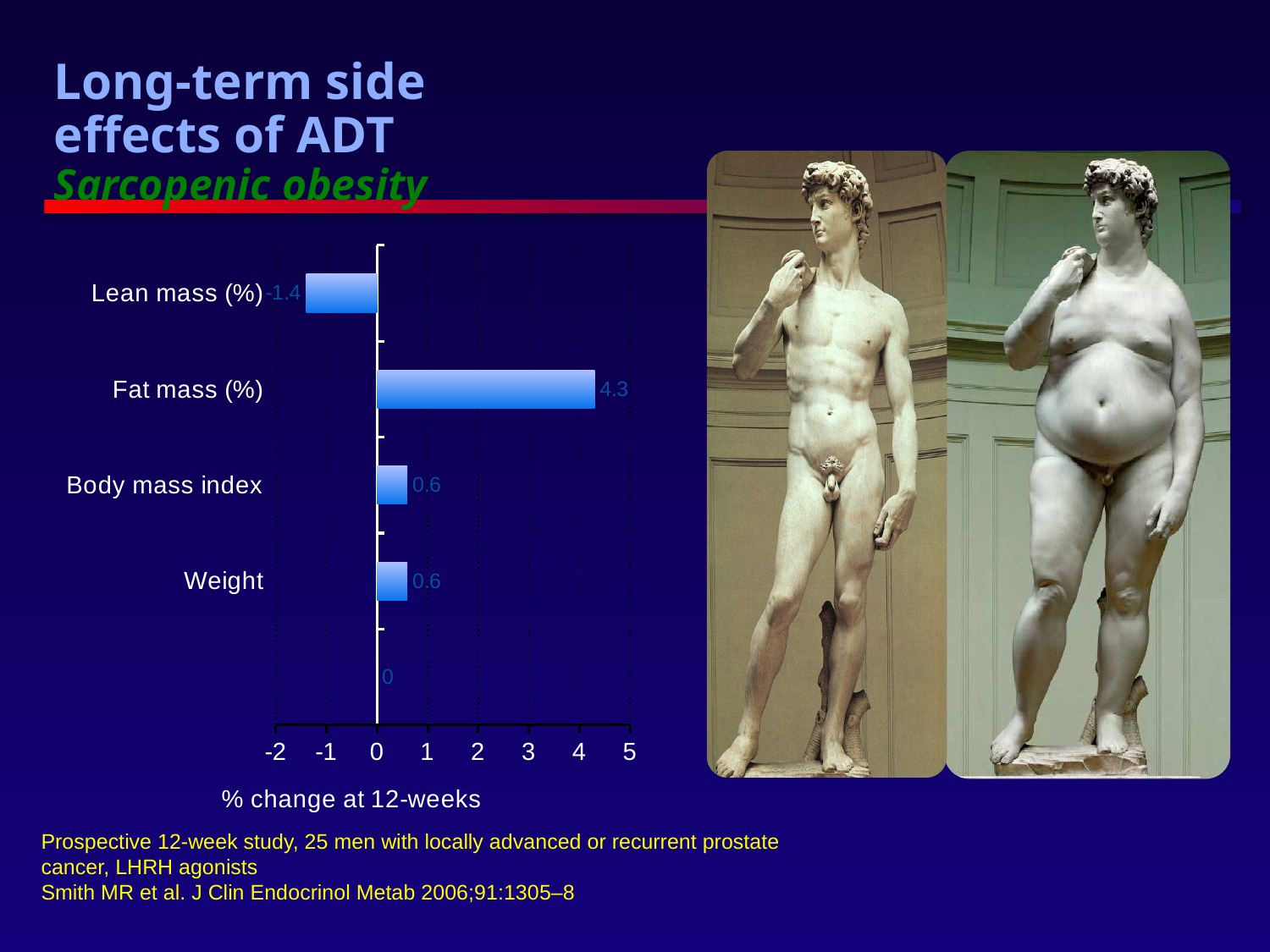
What is the difference between the values for Fat mass (%) and Body mass index? 3.7 Which is larger, the value for Fat mass (%) or the value for Weight? Fat mass (%) Which category has the lowest value in the chart? Lean mass (%) What is the value for Body mass index in the chart? 0.6 Which category has the highest value in the chart? Fat mass (%) What is the value for Fat mass (%) in the chart? 4.3 What kind of chart is shown on the slide? Bar chart What is the value for Weight in the chart? 0.6 What is the value for Lean mass (%) in the chart? -1.4 Is the value for Fat mass (%) greater or less than 3? greater What is the difference between the values for Fat mass (%) and Lean mass (%)? 5.7 What is the title of the x axis of the chart? % change at 12-weeks